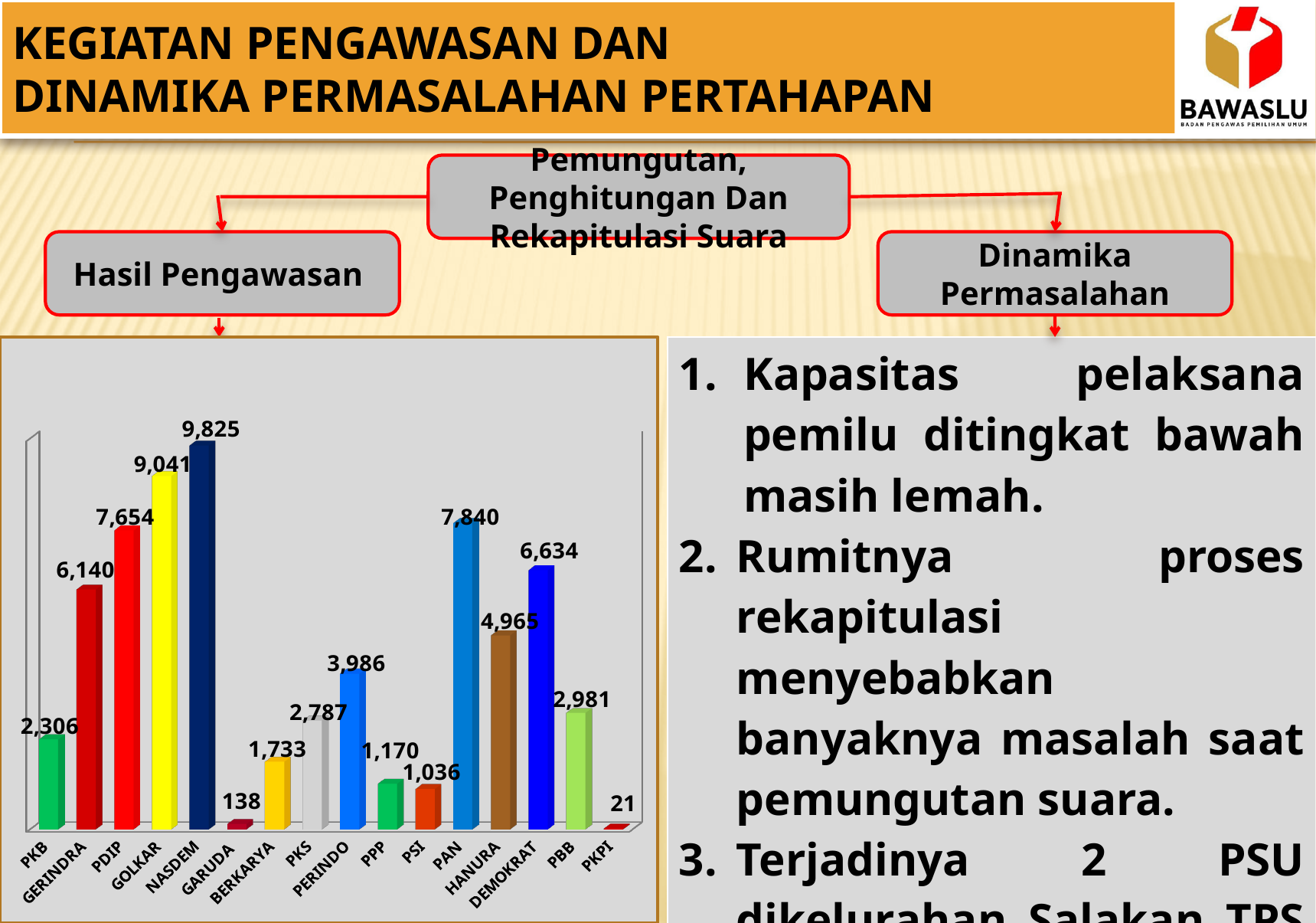
Which is larger, the value for GERINDRA or the value for DEMOKRAT? DEMOKRAT What is the difference between the values for PAN and DEMOKRAT? 1,206 What kind of chart is shown on the slide? Bar chart What is the value for HANURA? 4,965 Which party has the lowest value? PKPI What is the value for NASDEM? 9,825 Which party has the highest value? NASDEM What is the value for GARUDA? 138 What is the difference between the values for NASDEM and GOLKAR? 784 How many parties are shown in the chart? 16 What is the value for PKS? 2,787 Which is larger, the value for PPP or the value for PSI? PPP